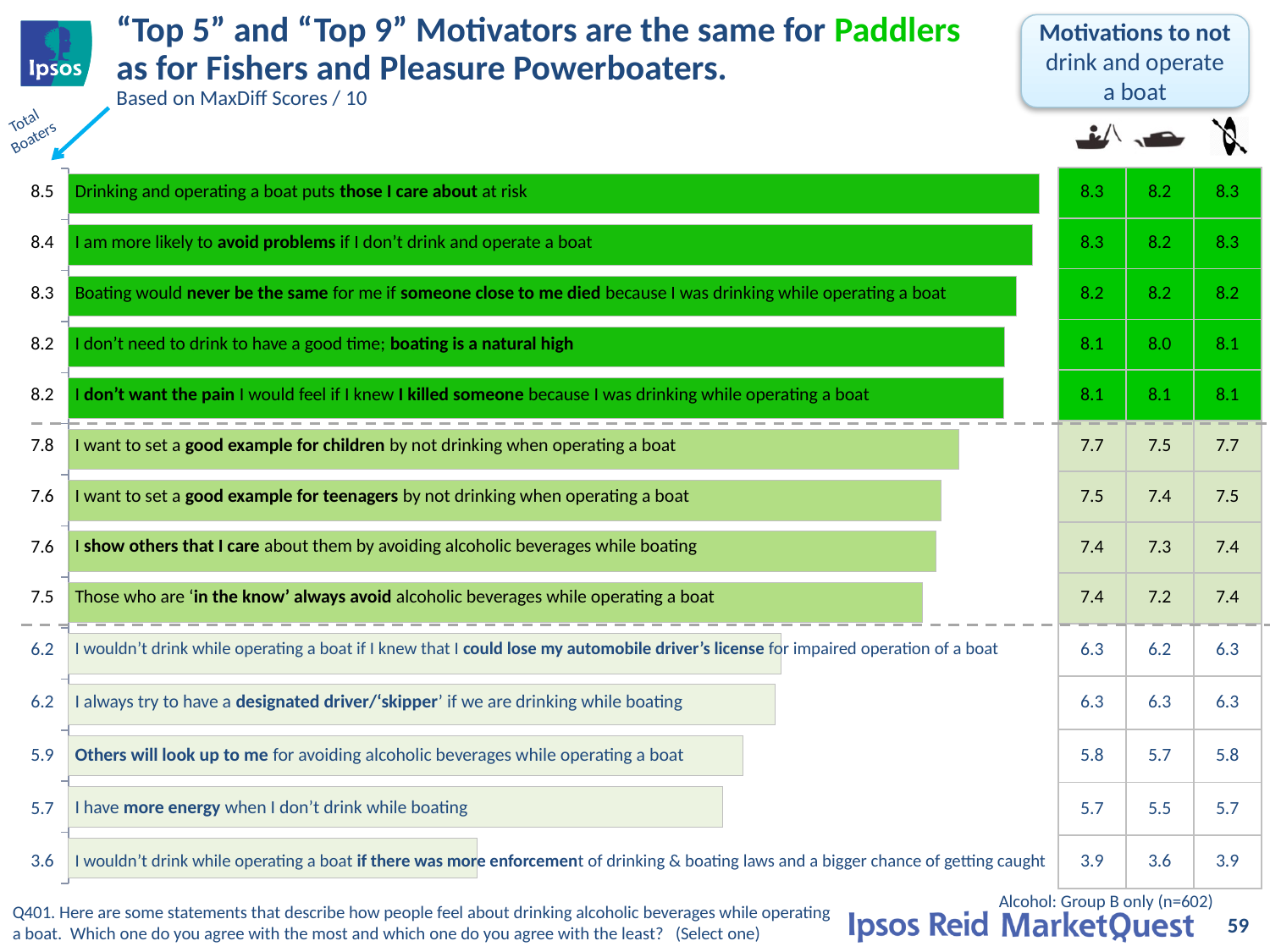
What is the difference between the Total Boaters score for "good example for children" (7.8) and "designated driver/'skipper'" (6.2)? 1.6 What is the Total Boaters score for "I have more energy when I don't drink while boating"? 5.7 What is the difference between the highest Total Boaters score (8.5) and the lowest (3.6)? 4.9 According to the subtitle, what are the scores based on? MaxDiff Scores / 10 What is the Total Boaters score for "Others will look up to me for avoiding alcoholic beverages while operating a boat"? 5.9 Which has a higher Total Boaters score: setting a good example for children or setting a good example for teenagers? Good example for children Which statement has the lowest Total Boaters score? I wouldn't drink while operating a boat if there was more enforcement of drinking & boating laws and a bigger chance of getting caught Do the Total Boaters scores increase or decrease going from the top bar to the bottom bar? Decrease What is the Total Boaters score for "I don't need to drink to have a good time; boating is a natural high"? 8.2 Which statement has the highest Total Boaters score? Drinking and operating a boat puts those I care about at risk How many statements (bars) are shown in the chart? 14 What kind of chart is used to show the Total Boaters scores? Bar chart